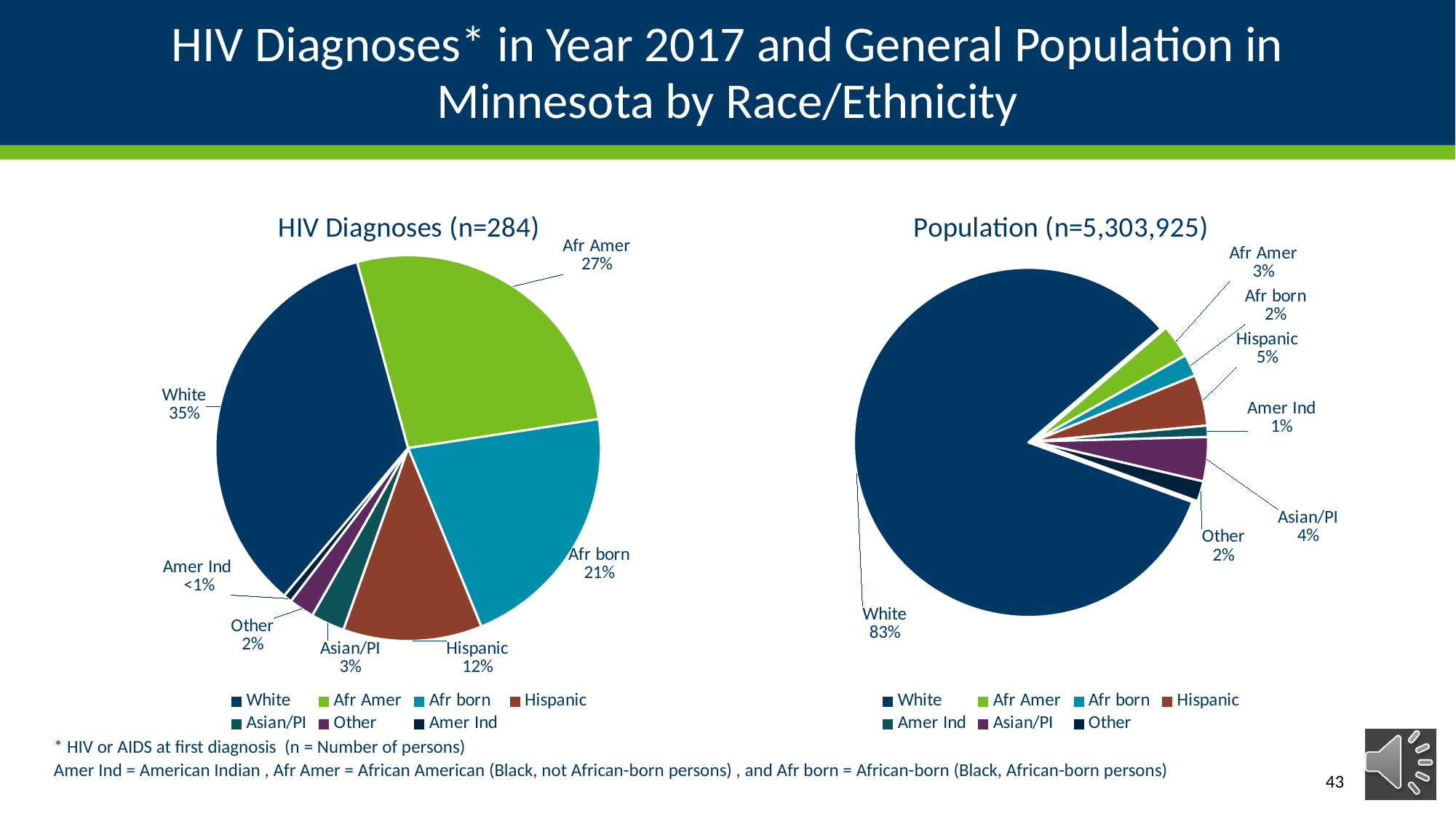
In the HIV Diagnoses (n=284) chart, which category has the largest slice? White In the Population (n=5,303,925) chart, what share is Asian/PI? 4% In the HIV Diagnoses (n=284) chart, which is larger, the Afr born share or the Hispanic share? Afr born In the HIV Diagnoses (n=284) chart, what share is Hispanic? 12% What is the title of the chart on the left of the slide? HIV Diagnoses (n=284) In the HIV Diagnoses (n=284) chart, what is the difference in percentage points between the White and Afr Amer shares? 8 In the Population (n=5,303,925) chart, which labelled category has the smallest share? Amer Ind In the HIV Diagnoses (n=284) chart, what share of diagnoses is Afr Amer? 27% In the Population (n=5,303,925) chart, what is the difference in percentage points between the Hispanic and Afr born shares? 3 In the Population (n=5,303,925) chart, what share of the population is White? 83% What kind of chart is the Population (n=5,303,925) chart? Pie chart How many categories does the legend of the HIV Diagnoses (n=284) chart list? 7